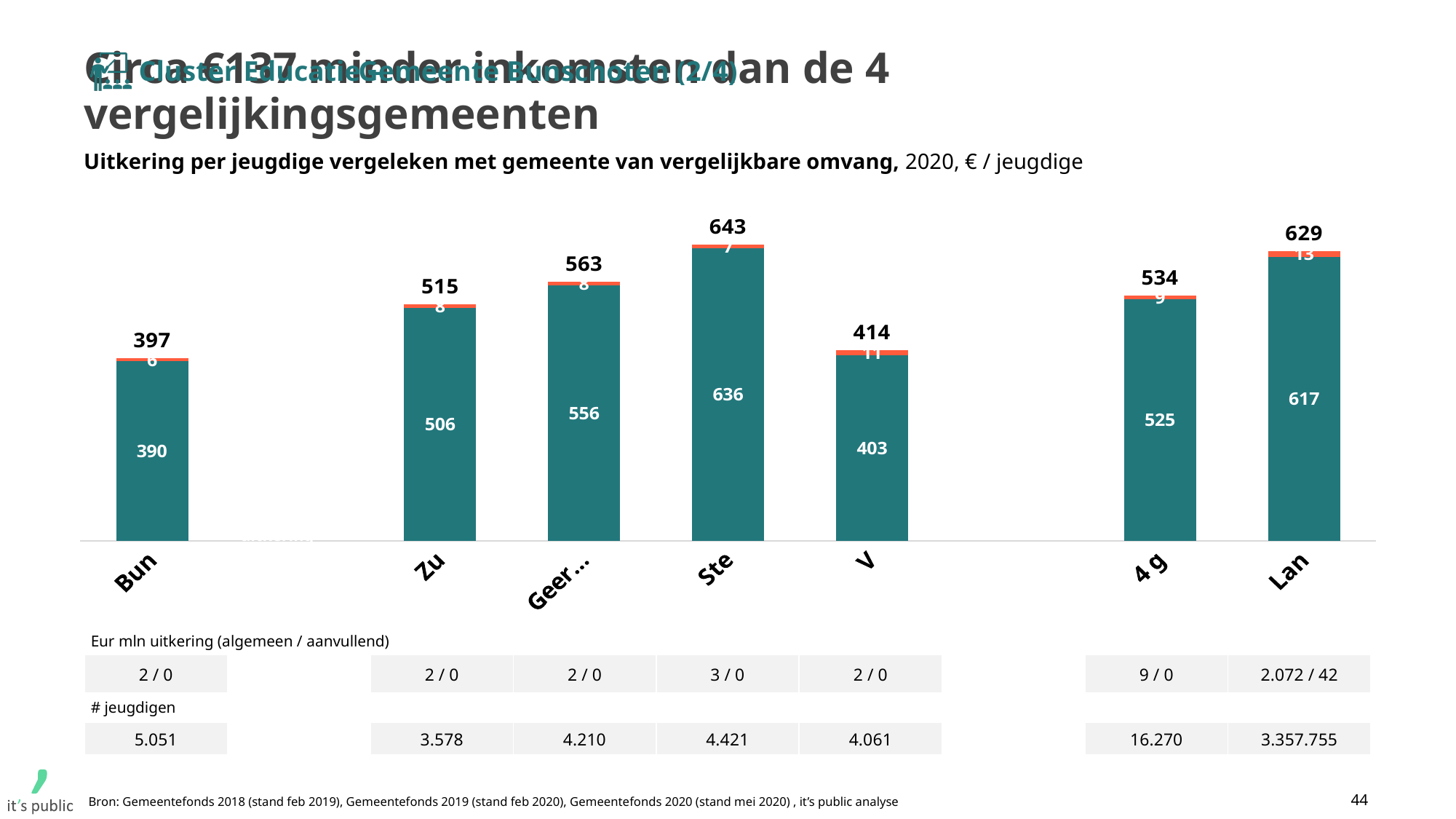
What is the value of the large teal segment of the bar for Ste? 636 What is the total value shown above the bar for Bun? 397 According to the subtitle, in what unit are the values expressed? € / jeugdige What is the total value shown above the bar for 4 g? 534 How many bars are plotted in the chart? 7 What is the difference between the total for Ste and the total for Lan? 14 What is the value of the large teal segment of the bar for V? 403 What is the difference between the total for Lan and the total for Bun? 232 Which category has the highest total value? Ste Which category has the lowest total value? Bun Which has a larger total, Zu or V? Zu What kind of chart is shown on the slide? Stacked bar chart